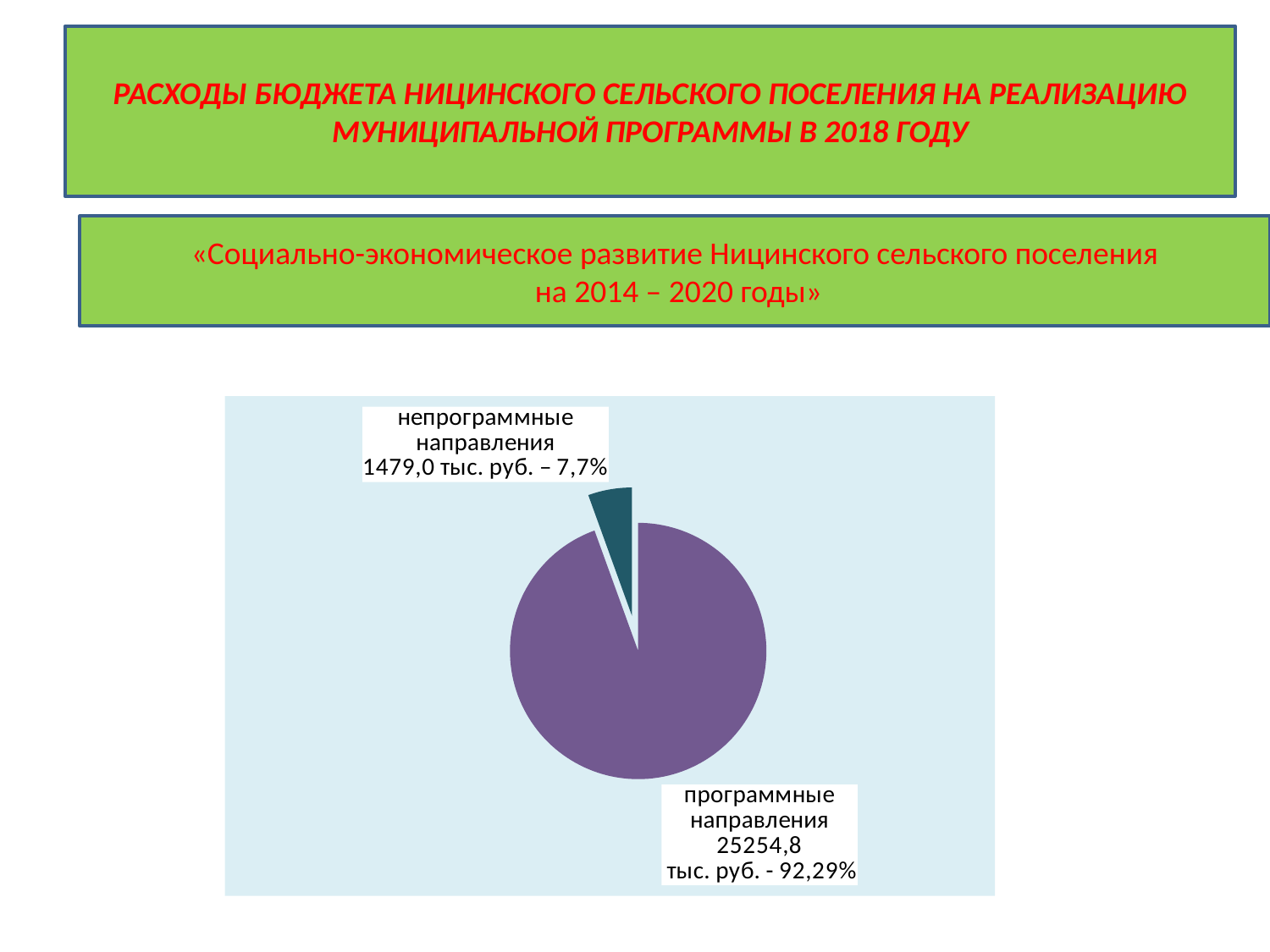
Which slice is the largest in the pie chart? программные направления What kind of chart is shown on the slide? pie chart Which is larger, программные направления or непрограммные направления? программные направления What is the total of the two slices in тыс. руб.? 26733,8 тыс. руб. What colour is the slice for непрограммные направления? dark teal What share of the pie does программные направления take? 92,29% What is the value for непрограммные направления? 1479,0 тыс. руб. What is the difference between программные направления and непрограммные направления in тыс. руб.? 23775,8 тыс. руб. What share of the pie does непрограммные направления take? 7,7% What is the value for программные направления? 25254,8 тыс. руб. Which slice is the smallest in the pie chart? непрограммные направления How many slices does the pie chart have? 2